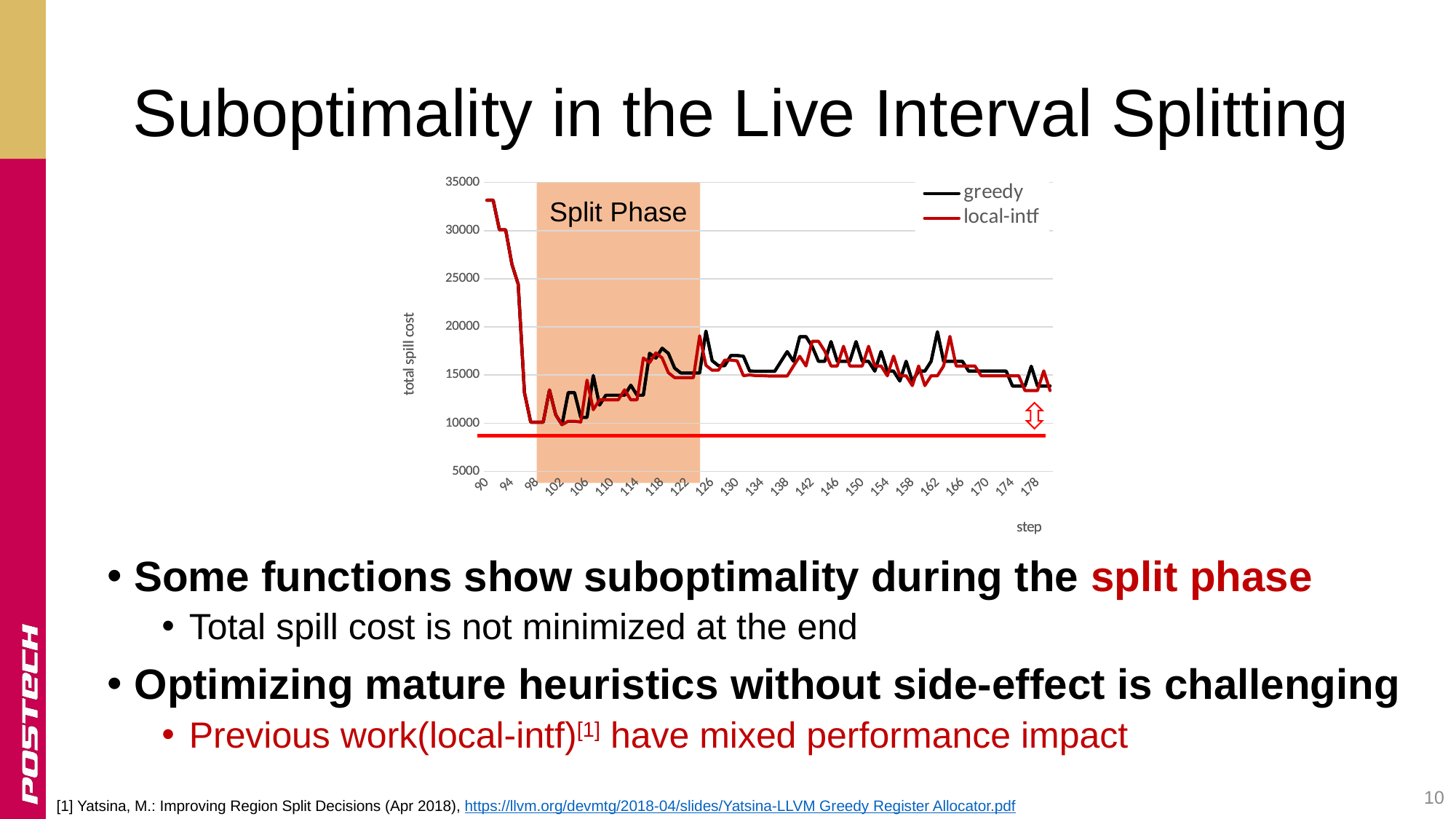
What kind of chart is shown on the slide? line chart What is the last step label shown on the chart's x axis? 178 Is the total spill cost for greedy at step 162 greater or less than 15000? greater Is the total spill cost at step 100 greater or less than 20000? less What label is shown on the chart's y axis? total spill cost Is the total spill cost at step 130 greater or less than 15000? greater What is the highest value shown on the chart's y axis? 35000 Do the values generally rise or fall along the x axis between step 102 and step 122? rise Do the values rise or fall along the x axis between step 90 and step 98? fall How many series does the chart's legend list? 2